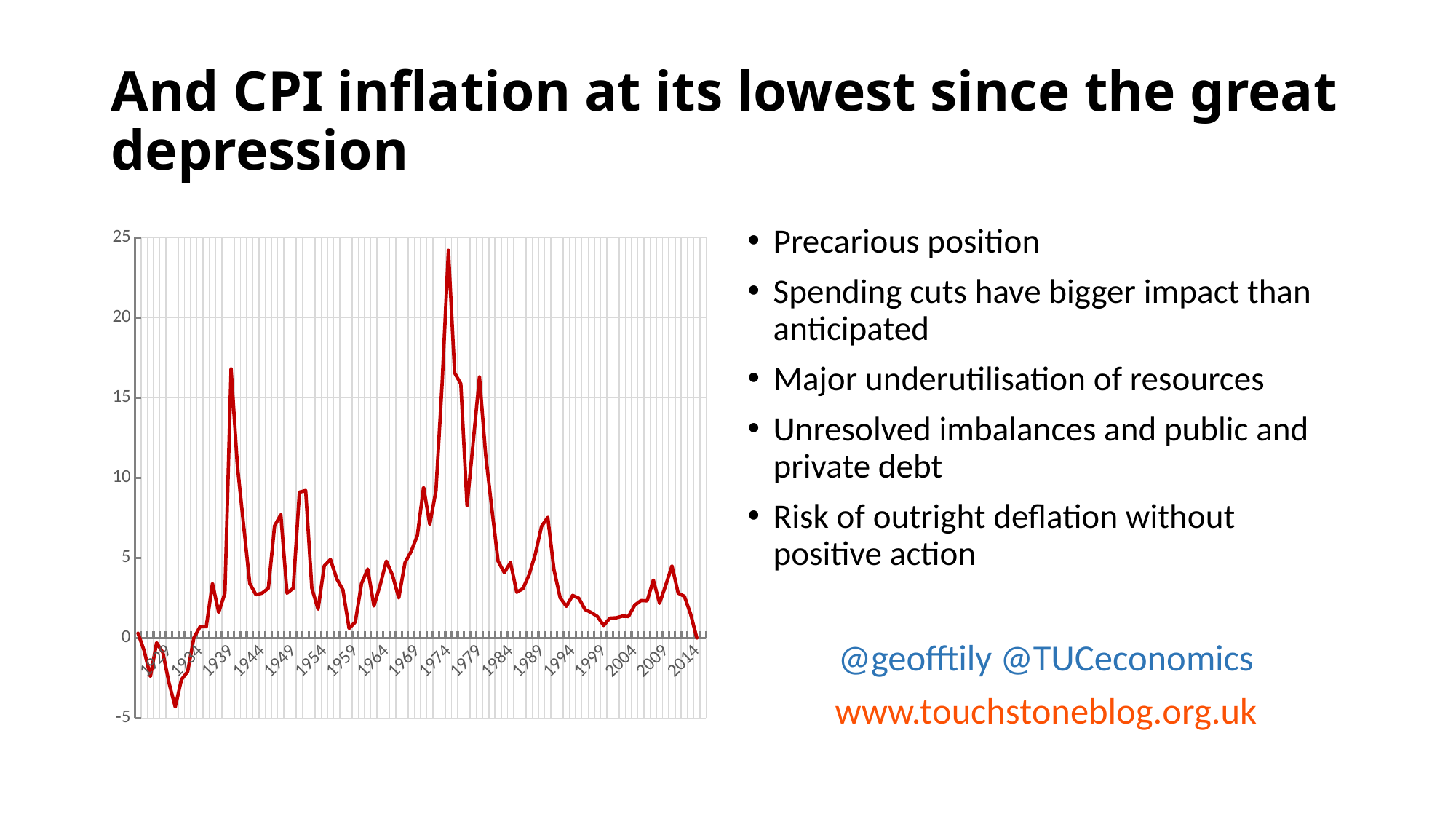
Is the value of the line around 1999 greater or less than 5? less In which decade does the line reach its lowest point? 1930s What is the lowest value shown on the vertical axis of the chart? -5 Does the line rise or fall between 2009 and 2014? fall In which decade does the line reach its highest point? 1970s Is the value of the line around 1975 larger or smaller than the value around 1990? larger What kind of chart is shown on the slide? line chart Is the value of the line at 2014 greater or less than 5? less What is the highest value shown on the vertical axis of the chart? 25 Is the peak value of the line in the mid-1970s greater or less than 20? greater